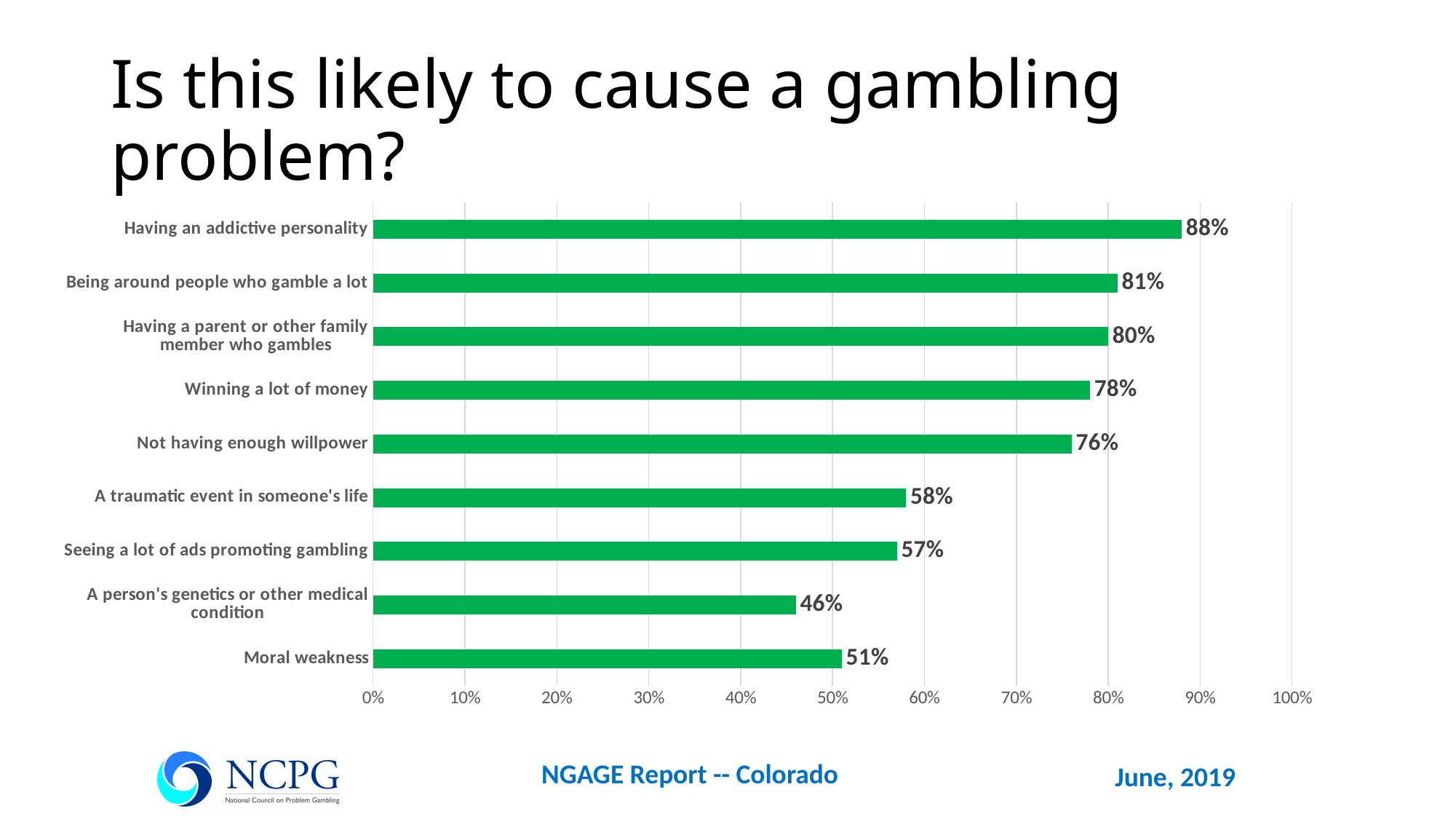
What kind of chart is shown on the slide? Bar chart Which is larger: the value for 'Seeing a lot of ads promoting gambling' or the value for 'A person's genetics or other medical condition'? Seeing a lot of ads promoting gambling Which category has the highest value? Having an addictive personality Is the value for 'Being around people who gamble a lot' greater or less than 70%? greater What is the value for 'Moral weakness'? 51% What colour are the bars in the chart? Green How many categories are shown in the chart? 9 What is the difference between 'Winning a lot of money' and 'A traumatic event in someone's life'? 20% Which category has the lowest value? A person's genetics or other medical condition What percentage of respondents said having an addictive personality is likely to cause a gambling problem? 88% What is the difference between the values for 'Having an addictive personality' and 'Moral weakness'? 37% What is the value for 'Not having enough willpower'? 76%